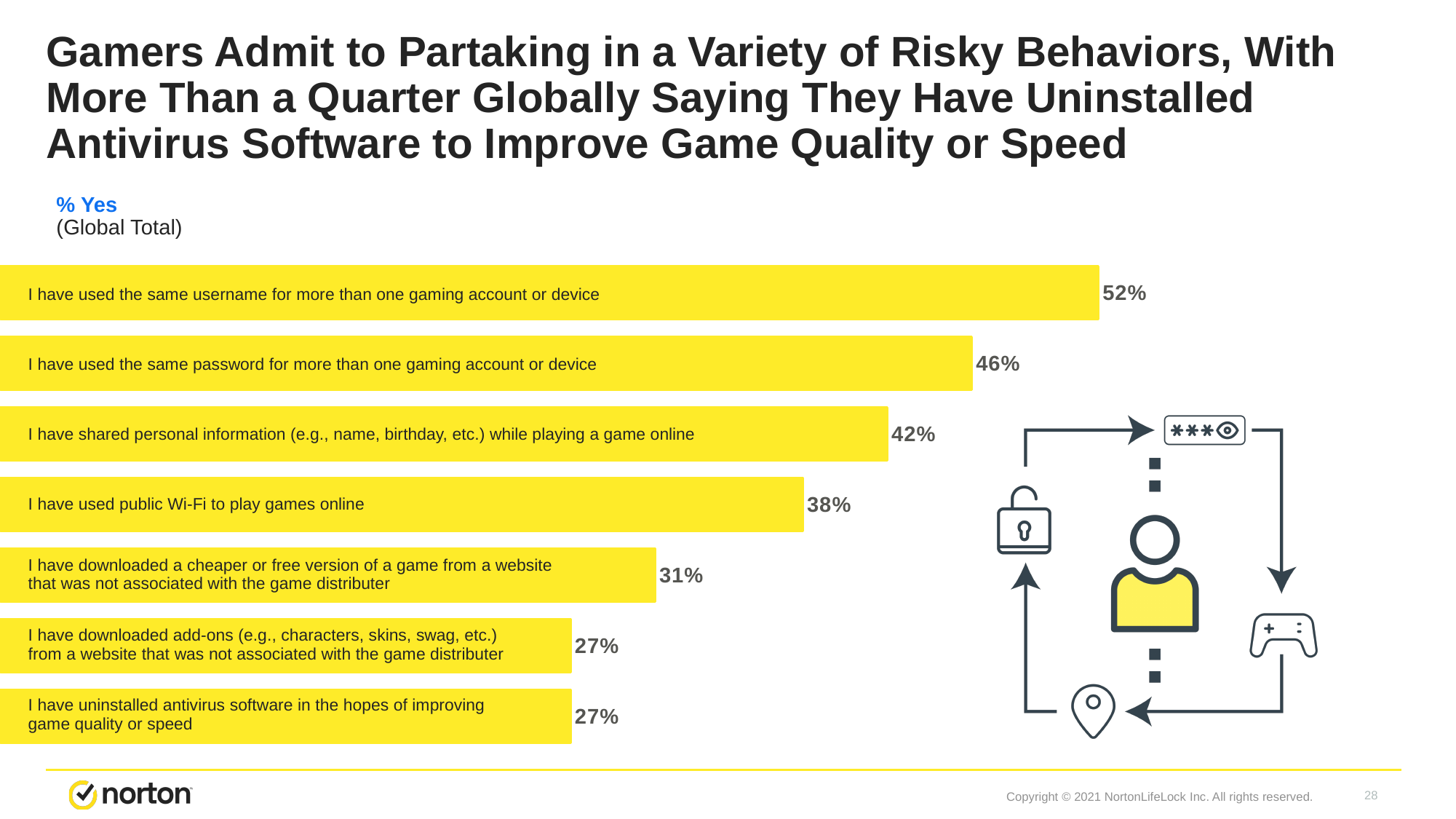
Which is larger: the share who have shared personal information while playing a game online, or the share who have used public Wi-Fi to play games online? Shared personal information while playing a game online Which risky behavior has the highest % Yes? I have used the same username for more than one gaming account or device How many risky behaviors are shown in the chart? 7 What colour are the bars in the chart? Yellow What type of chart is shown on the slide? Bar chart What percentage of gamers say they have shared personal information while playing a game online? 42% What percentage of gamers say they have used the same username for more than one gaming account or device? 52% What percentage of gamers say they have uninstalled antivirus software in the hopes of improving game quality or speed? 27% What is the difference in percentage points between using the same username and using the same password for more than one gaming account or device? 6 What is the difference in percentage points between using public Wi-Fi to play games online and downloading a cheaper or free version of a game from a non-distributer website? 7 What does the chart's subtitle say the values represent? % Yes (Global Total) What percentage of gamers say they have used public Wi-Fi to play games online? 38%